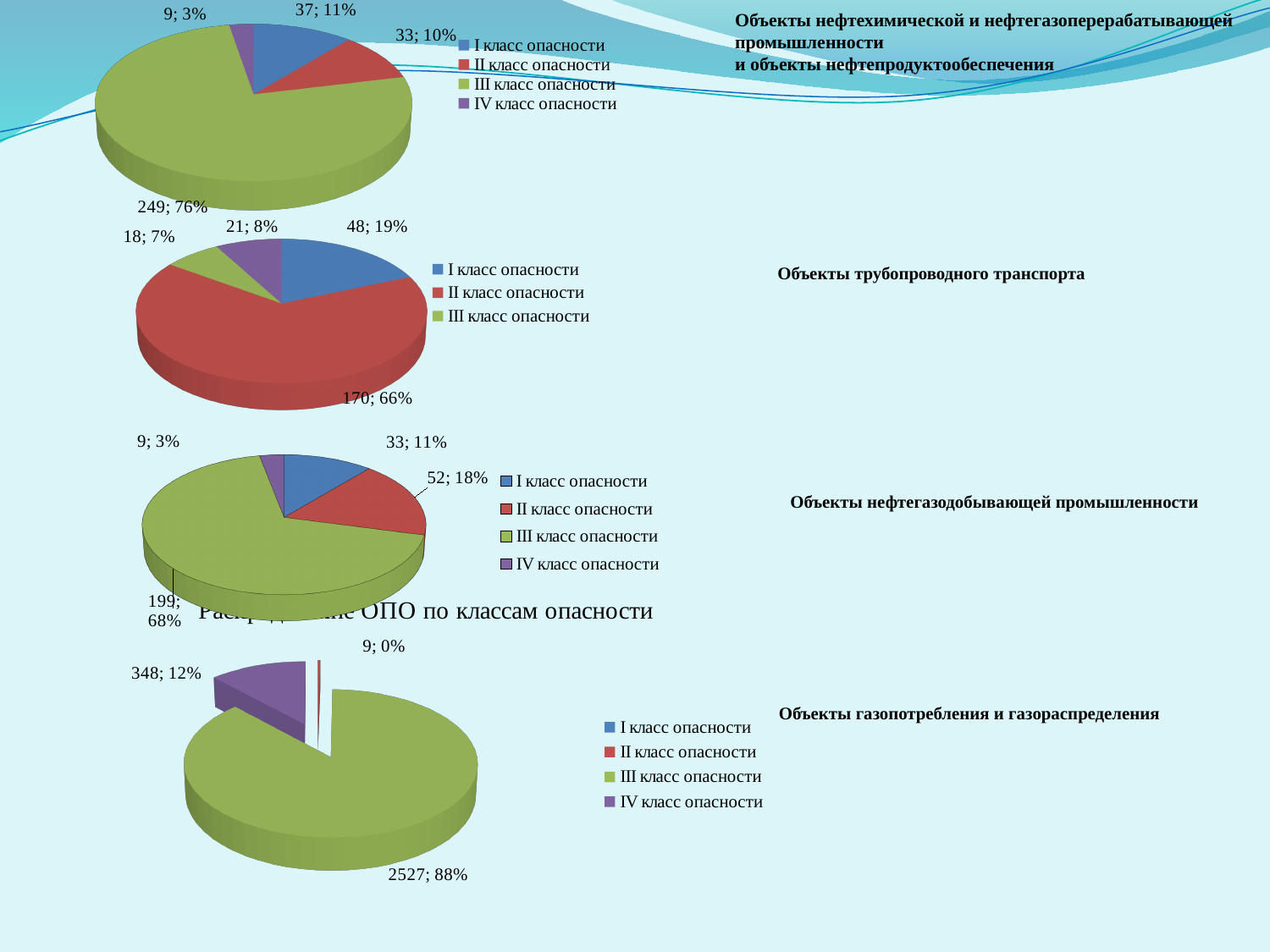
In the top pie chart (Объекты нефтехимической и нефтегазоперерабатывающей промышленности и объекты нефтепродуктообеспечения), what value is shown for I класс опасности? 37; 11% In the pie chart titled "Объекты трубопроводного транспорта", which is larger: I класс опасности or III класс опасности? I класс опасности What type of chart is used for "Объекты газопотребления и газораспределения"? Pie chart In the pie chart titled "Объекты нефтегазодобывающей промышленности", what value is shown for II класс опасности? 52; 18% In the pie chart titled "Объекты нефтегазодобывающей промышленности", what share of the pie does III класс опасности take? 68% In the pie chart titled "Объекты трубопроводного транспорта", what value is shown for II класс опасности? 170; 66% How many entries does the legend of the pie chart titled "Объекты трубопроводного транспорта" list? 3 In the top pie chart (Объекты нефтехимической и нефтегазоперерабатывающей промышленности и объекты нефтепродуктообеспечения), which hazard class has the largest slice? III класс опасности In the pie chart titled "Объекты трубопроводного транспорта", which hazard class has the largest slice? II класс опасности In the pie chart titled "Объекты газопотребления и газораспределения", what value is shown for III класс опасности? 2527; 88% In the pie chart titled "Объекты нефтегазодобывающей промышленности", which hazard class has the smallest slice? IV класс опасности In the pie chart titled "Объекты газопотребления и газораспределения", what is the difference between the counts for III класс опасности and IV класс опасности? 2179